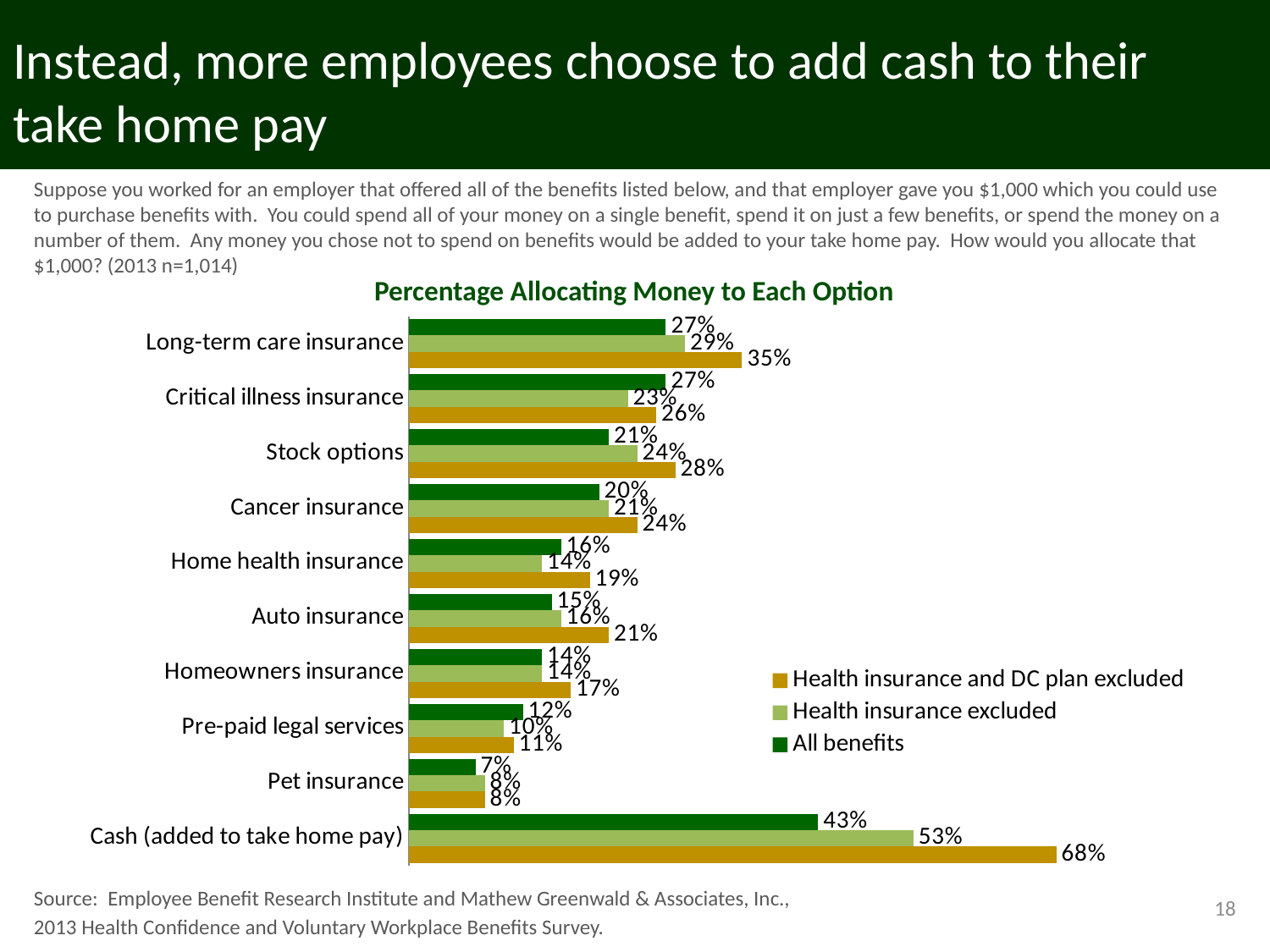
For cash (added to take home pay), which is larger: the 'Health insurance excluded' value or the 'All benefits' value? Health insurance excluded What is the difference between the 'Health insurance and DC plan excluded' and 'All benefits' values for cash (added to take home pay)? 25 percentage points What type of chart is shown on the slide? Bar chart How many options (categories) are shown on the chart? 10 What is the value for cash (added to take home pay) in the 'All benefits' series? 43% How many series does the legend list? 3 What is the title of the chart? Percentage Allocating Money to Each Option What is the value for long-term care insurance in the 'Health insurance and DC plan excluded' series? 35% Which option has the highest value in the 'Health insurance and DC plan excluded' series? Cash (added to take home pay) What percentage of employees allocated money to cash (added to take home pay) in the 'Health insurance and DC plan excluded' series? 68% Which option has the lowest value in the 'All benefits' series? Pet insurance What is the value for stock options in the 'Health insurance and DC plan excluded' series? 28%